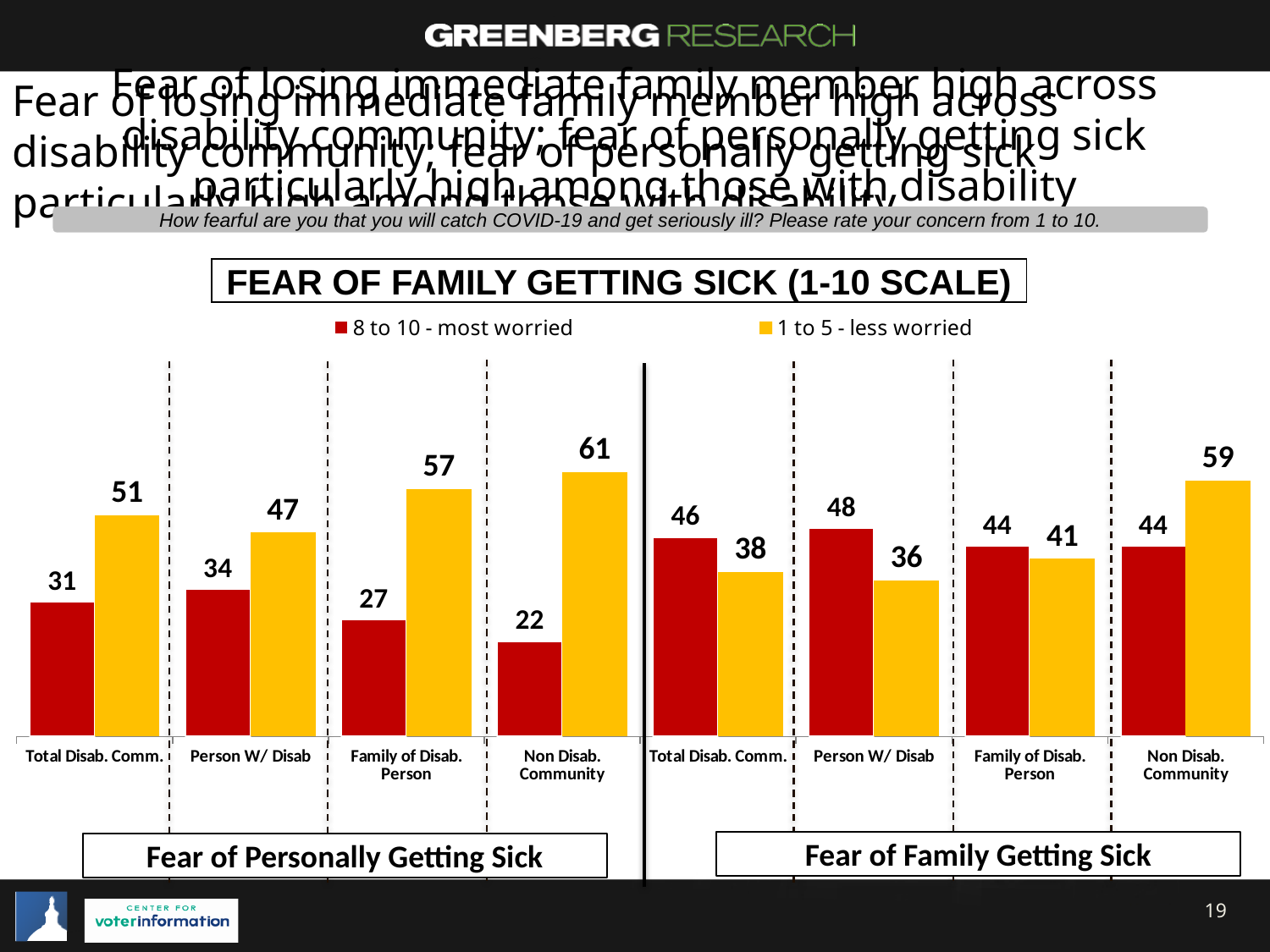
In the Fear of Personally Getting Sick panel, which category has the lowest '8 to 10 - most worried' value? Non Disab. Community In the Fear of Personally Getting Sick panel, what is the value for '8 to 10 - most worried' for Total Disab. Comm.? 31 What colour represents the '1 to 5 - less worried' series? Yellow How many series does the legend list? 2 In the Fear of Family Getting Sick panel, what is the value for '1 to 5 - less worried' for Non Disab. Community? 59 In the Fear of Family Getting Sick panel, which category has the highest '8 to 10 - most worried' value? Person W/ Disab In the Fear of Family Getting Sick panel, what is the difference between the '1 to 5 - less worried' and '8 to 10 - most worried' values for Non Disab. Community? 15 In the Fear of Personally Getting Sick panel, which category has the highest '1 to 5 - less worried' value? Non Disab. Community In the Fear of Personally Getting Sick panel, what is the difference between the '1 to 5 - less worried' and '8 to 10 - most worried' values for Family of Disab. Person? 30 In the Fear of Family Getting Sick panel, which is larger for Person W/ Disab: '8 to 10 - most worried' or '1 to 5 - less worried'? 8 to 10 - most worried How many categories are shown in the Fear of Personally Getting Sick panel? 4 What kind of chart is shown on the slide? Bar chart